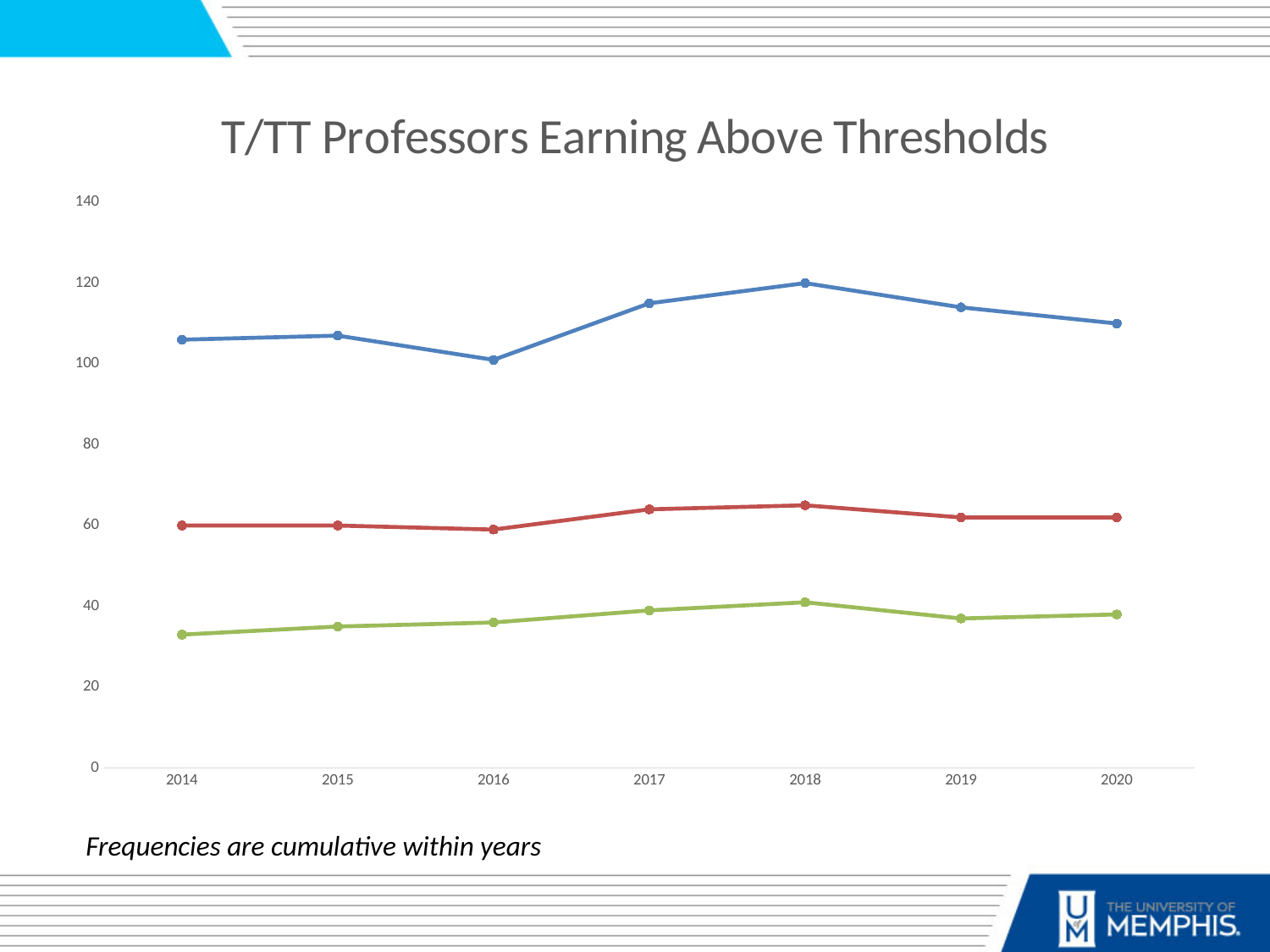
What kind of chart is shown on the slide? line chart What is the title of the chart? T/TT Professors Earning Above Thresholds In which year does the green line reach its highest value? 2018 Does the blue line rise or fall from 2018 to 2020? fall Is the value of the green line in 2014 greater or less than 40? less How many lines are plotted on the chart? 3 In which year does the blue line reach its lowest value? 2016 In which year does the blue line reach its highest value? 2018 Is the value of the blue line in 2018 greater or less than 100? greater Is the value of the red line in 2018 greater or less than 60? greater How many years are shown on the x axis? 7 Which line has the higher value in 2017, the blue line or the red line? the blue line